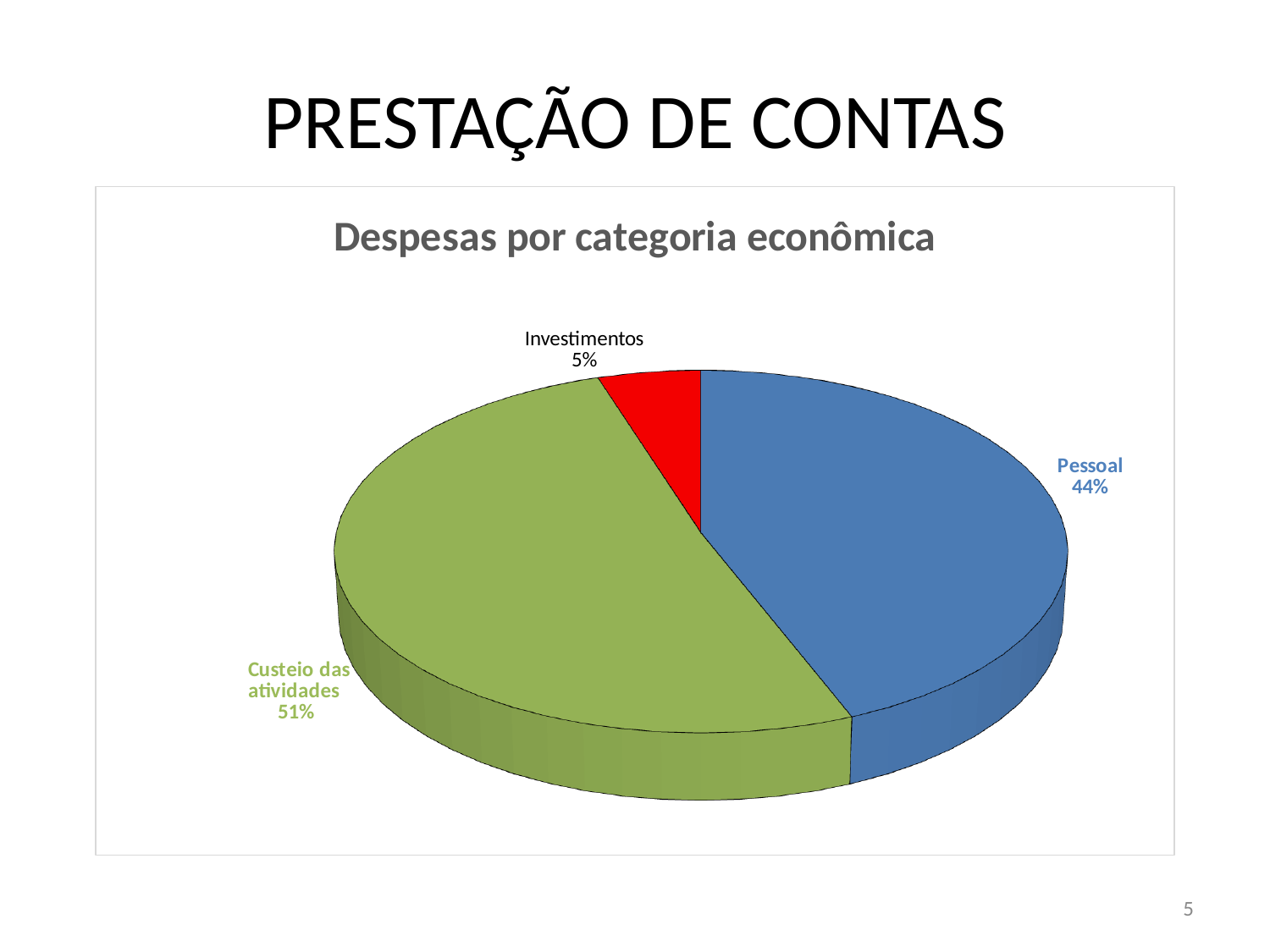
What colour is the Investimentos slice? Red Which category has the largest slice? Custeio das atividades How many categories are shown in the pie chart? 3 What kind of chart is shown on the slide? Pie chart What share of the pie does Custeio das atividades represent? 51% What is the difference in percentage points between Pessoal and Investimentos? 39 Which category has the smallest slice? Investimentos What is the title of the chart? Despesas por categoria econômica Which is larger, Pessoal or Investimentos? Pessoal What is the difference in percentage points between Custeio das atividades and Pessoal? 7 What share of the pie does Pessoal represent? 44% What share of the pie does Investimentos represent? 5%